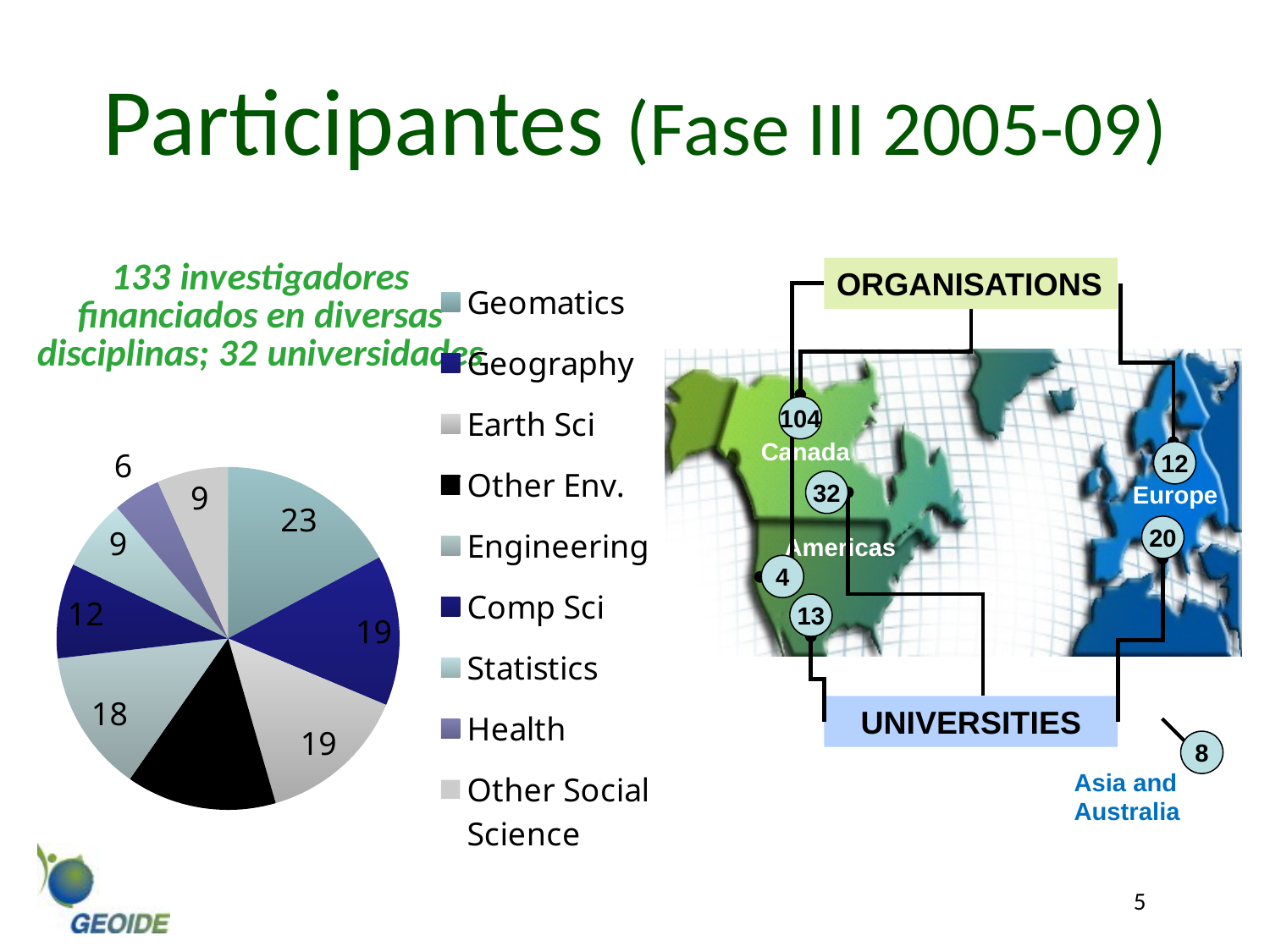
In the pie chart, what is the value for Comp Sci? 12 Which category has the largest slice in the pie chart? Geomatics In the pie chart, what is the value for Health? 6 In the pie chart, what is the value for Statistics? 9 In the pie chart, what is the value for Geomatics? 23 In the pie chart, what is the value for Engineering? 18 What kind of chart is shown on the left of the slide? pie chart Which category has the smallest slice in the pie chart? Health What is the difference between the values for Geomatics and Comp Sci in the pie chart? 11 How many categories does the pie chart's legend list? 9 In the pie chart, which is larger, Engineering or Comp Sci? Engineering What is the last entry in the pie chart's legend? Other Social Science